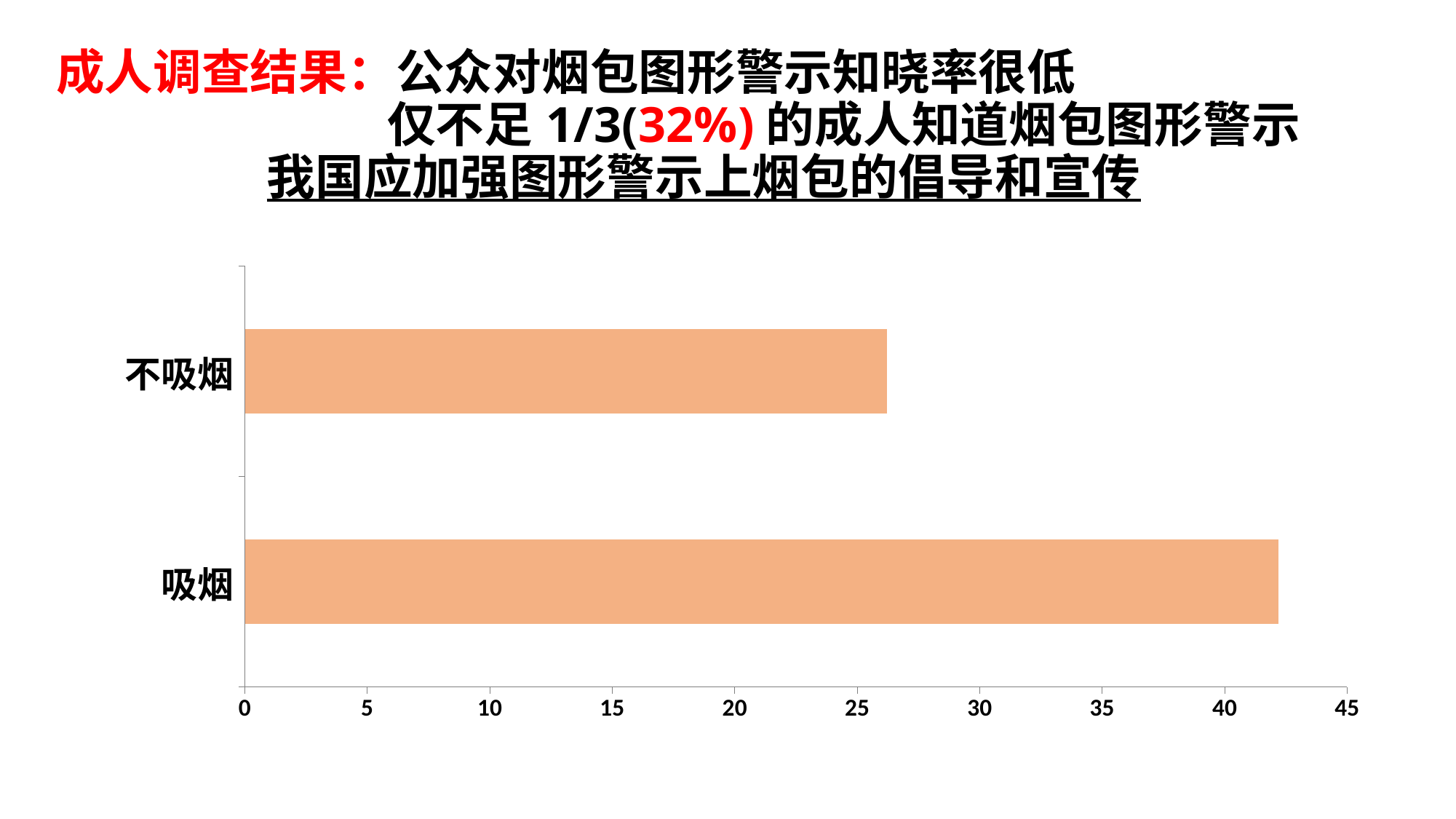
What kind of chart is shown on the slide? bar chart Which category has the lowest value in the bar chart? 不吸烟 What colour are the bars in the chart? orange What is the maximum value shown on the horizontal axis of the chart? 45 Is the value for 不吸烟 greater or less than 20? greater How many categories are plotted in the bar chart? 2 Is the value for 吸烟 greater or less than 45? less Is the value for 吸烟 greater or less than 40? greater Which is larger, the value for 吸烟 or the value for 不吸烟? 吸烟 Which category has the highest value in the bar chart? 吸烟